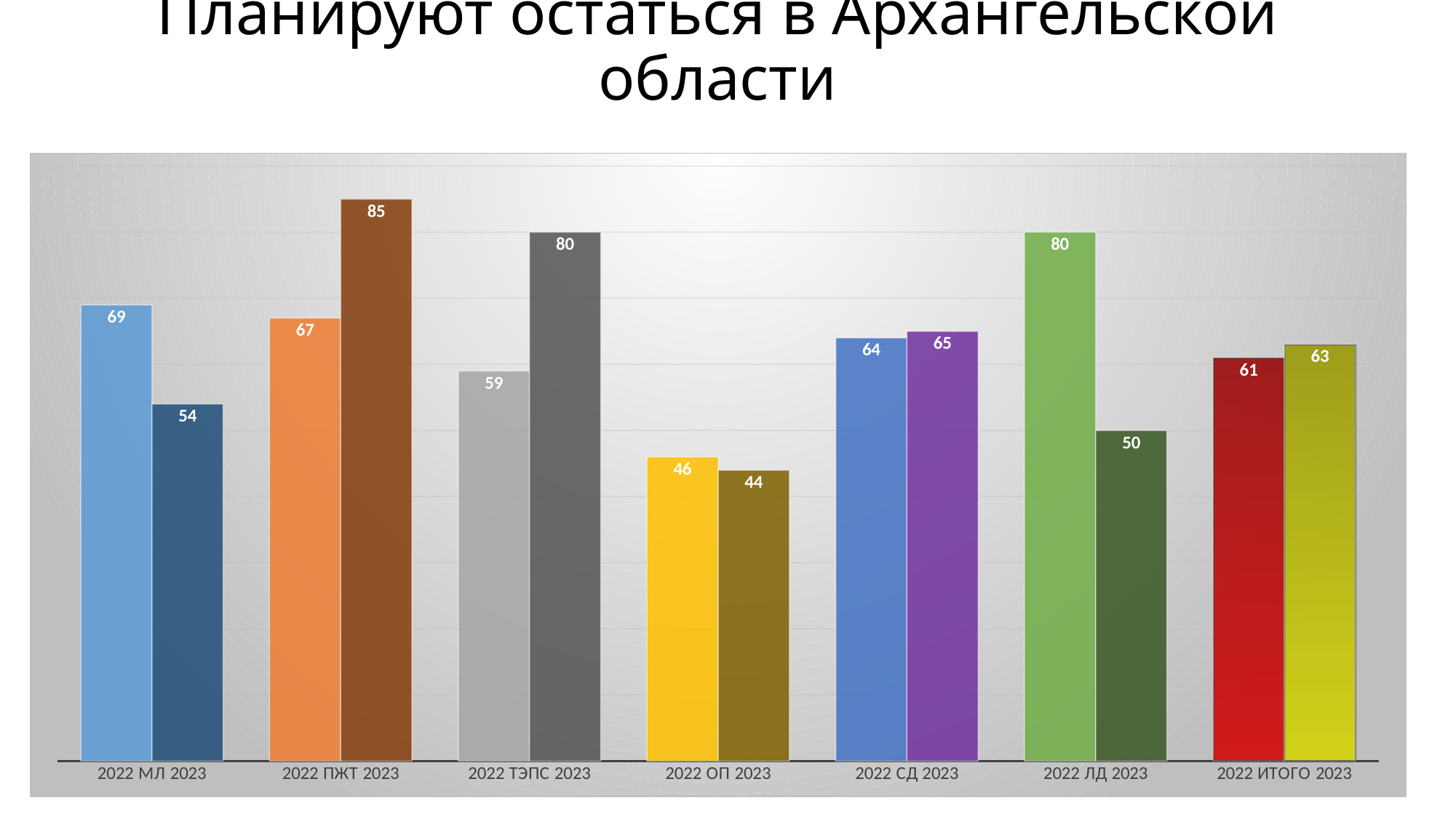
Which group has the lowest 2022 value? ОП What is the 2022 value for ИТОГО? 61 What is the title of the chart on the slide? Планируют остаться в Архангельской области What is the difference between the 2022 and 2023 values for ОП? 2 What is the 2023 value for ТЭПС? 80 What is the 2022 value for МЛ? 69 What is the 2023 value for ПЖТ? 85 Which group has the highest 2023 value? ПЖТ What kind of chart is shown on the slide? Bar chart For ТЭПС, which is larger: the 2022 value or the 2023 value? 2023 What is the difference between the 2023 and 2022 values for ЛД? 30 How many groups of bars are shown on the x axis? 7